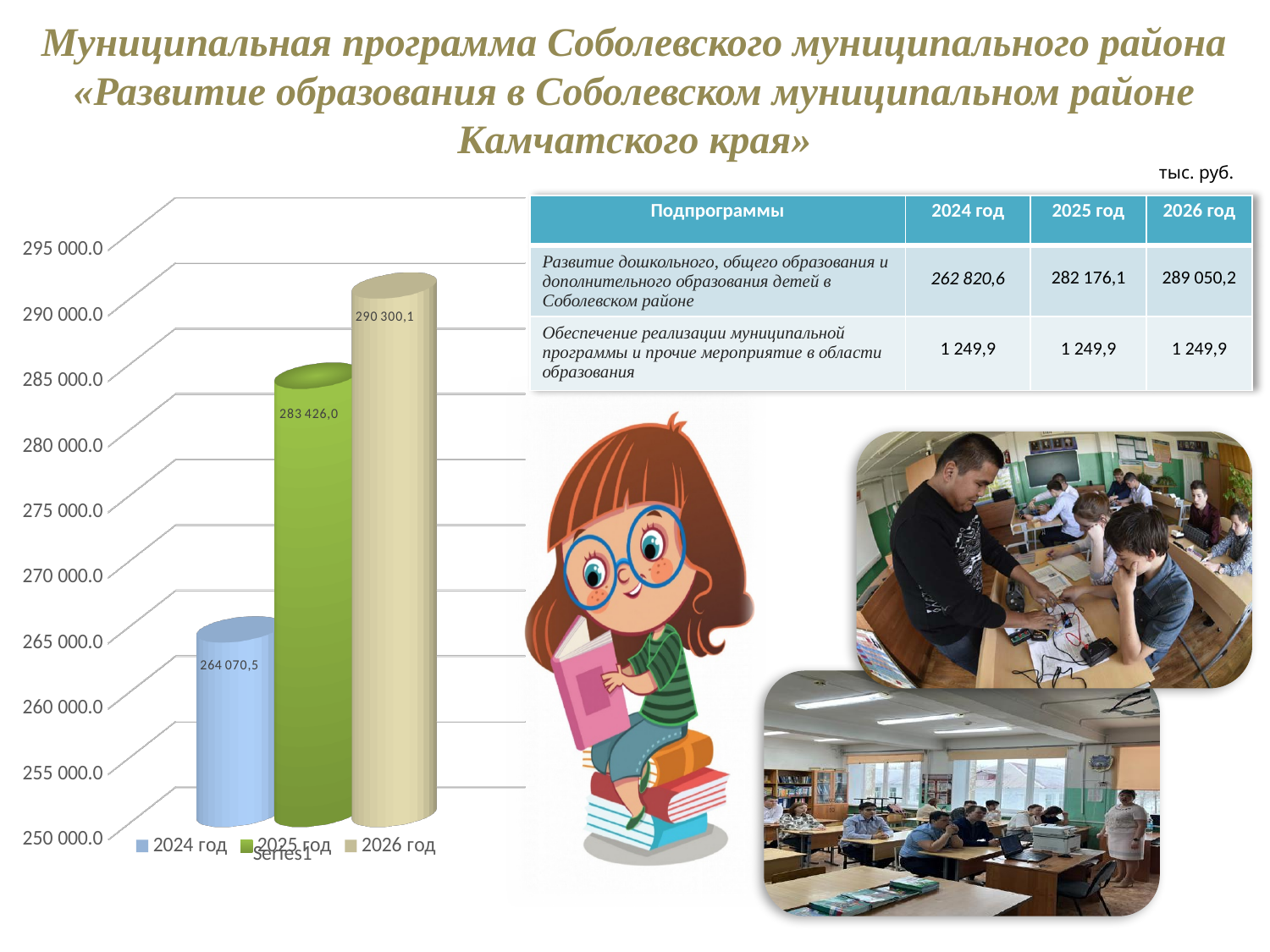
Which year has the highest value on the chart? 2026 год What is the value shown for 2024 год on the chart? 264 070,5 What is the value shown for 2026 год on the chart? 290 300,1 What is the value shown for 2025 год on the chart? 283 426,0 What is the difference between the values for 2026 год and 2024 год on the chart? 26 229,6 Which year has the lowest value on the chart? 2024 год What is the difference between the values for 2025 год and 2024 год on the chart? 19 355,5 Is the value for 2025 год greater or less than 280 000.0? greater How many entries does the chart legend list? 3 Which is larger on the chart, the value for 2025 год or the value for 2024 год? 2025 год How many bars are plotted on the chart? 3 What kind of chart is shown on the slide? bar chart